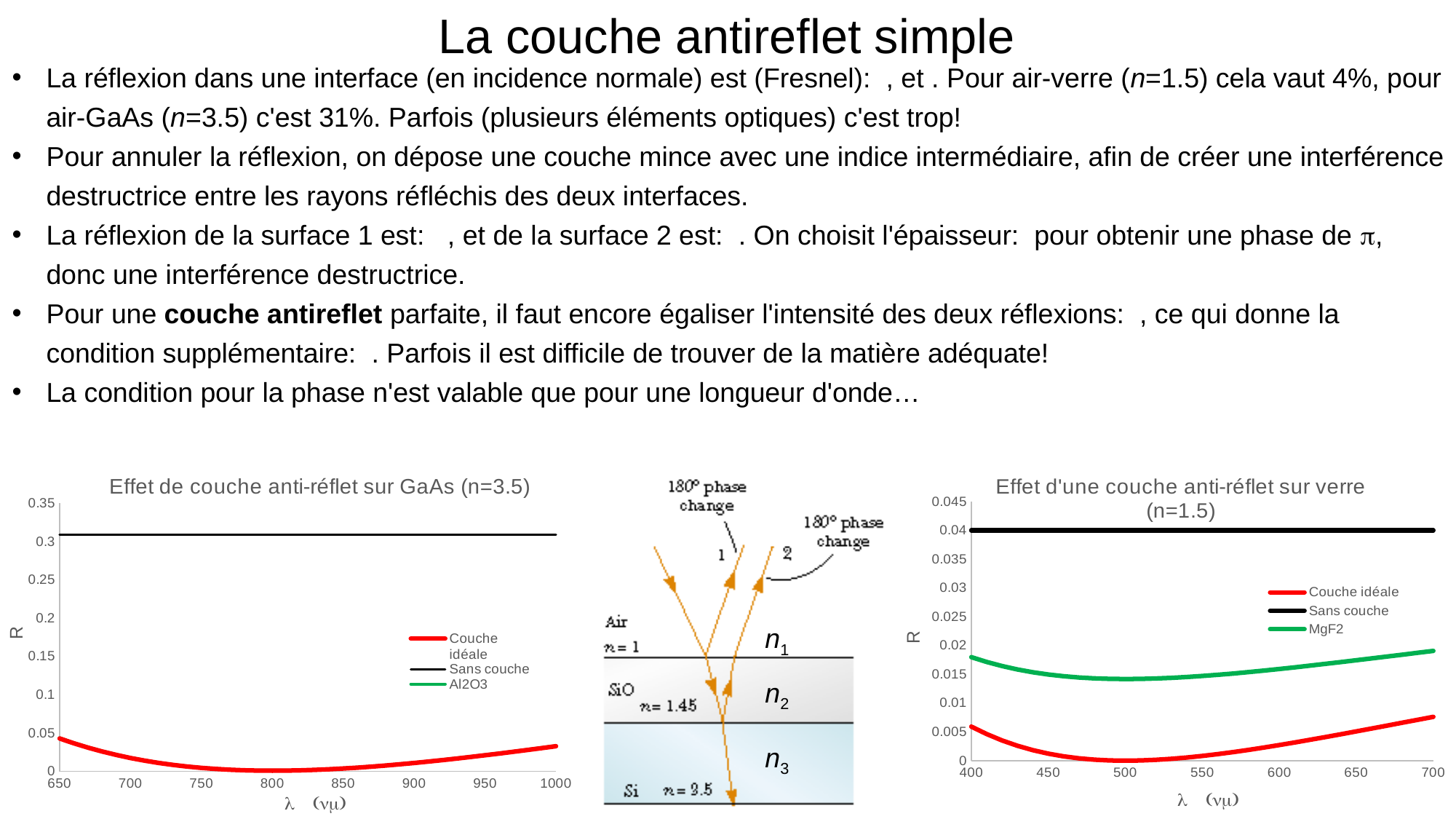
In the left chart 'Effet de couche anti-réflet sur GaAs (n=3.5)', is the value of the 'Sans couche' series greater or less than 0.3? greater In the right chart 'Effet d'une couche anti-réflet sur verre (n=1.5)', is the 'MgF2' value at λ = 400 greater or less than 0.02? less In the left chart 'Effet de couche anti-réflet sur GaAs (n=3.5)', is the 'Couche idéale' value at λ = 650 greater or less than 0.05? less In the left chart 'Effet de couche anti-réflet sur GaAs (n=3.5)', what colour is the 'Sans couche' line? black In the left chart 'Effet de couche anti-réflet sur GaAs (n=3.5)', does the 'Couche idéale' curve rise or fall between λ = 650 and λ = 800? fall How many series does the legend of the right chart 'Effet d'une couche anti-réflet sur verre (n=1.5)' list? 3 In the left chart 'Effet de couche anti-réflet sur GaAs (n=3.5)', which series has the higher value at λ = 650: 'Sans couche' or 'Couche idéale'? Sans couche In the right chart 'Effet d'une couche anti-réflet sur verre (n=1.5)', does the 'Couche idéale' curve rise or fall between λ = 550 and λ = 700? rise What is the x-axis label of the right chart 'Effet d'une couche anti-réflet sur verre (n=1.5)'? λ (νμ) In the right chart 'Effet d'une couche anti-réflet sur verre (n=1.5)', which series has the lowest value at λ = 500? Couche idéale What kind of chart is the left chart titled 'Effet de couche anti-réflet sur GaAs (n=3.5)'? line chart